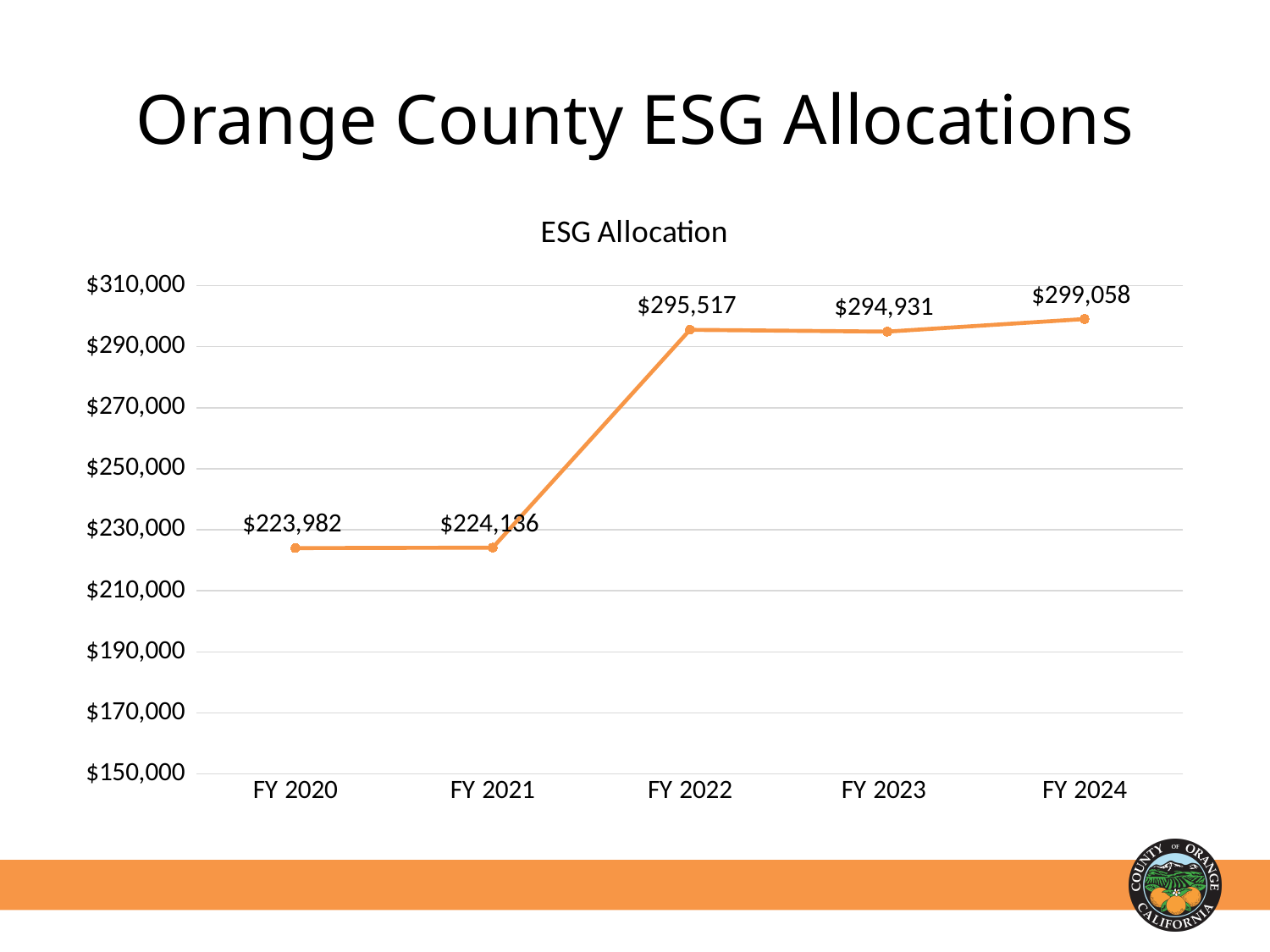
What is the difference between the ESG allocation for FY 2024 and FY 2022? $3,541 What is the ESG allocation for FY 2020? $223,982 What is the ESG allocation for FY 2022? $295,517 Which is larger, the ESG allocation for FY 2022 or FY 2023? FY 2022 Is the ESG allocation for FY 2020 greater or less than $250,000? less What is the difference between the ESG allocation for FY 2022 and FY 2020? $71,535 What kind of chart is shown on the slide? line chart What is the ESG allocation for FY 2024? $299,058 Which fiscal year has the highest ESG allocation? FY 2024 How many fiscal years are plotted on the chart? 5 Does the ESG allocation generally rise or fall from FY 2020 to FY 2024? rise What is the ESG allocation for FY 2023? $294,931